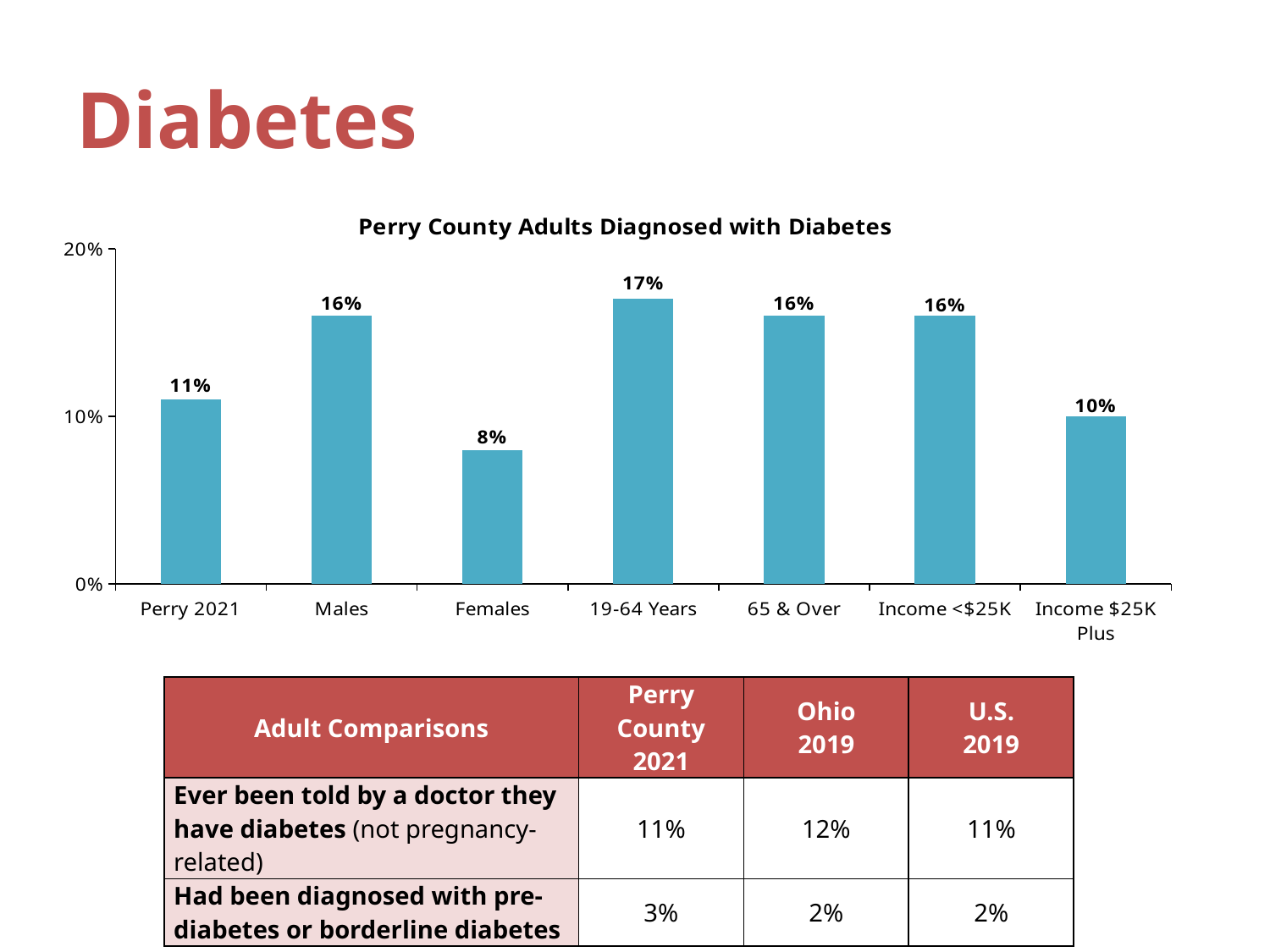
What is the difference between the values for Males and Females? 8% Which category has the lowest value in the chart? Females What is the value for Perry 2021 in the chart? 11% What is the title of the chart? Perry County Adults Diagnosed with Diabetes What kind of chart is shown on the slide? bar chart What is the value for Females in the chart? 8% Which category has the highest value in the chart? 19-64 Years What is the difference between the values for Income <$25K and Income $25K Plus? 6% What is the value for Income $25K Plus in the chart? 10% Which is larger, the value for Perry 2021 or the value for 65 & Over? 65 & Over How many categories are shown in the chart? 7 Is the value for Females greater or less than 10%? less